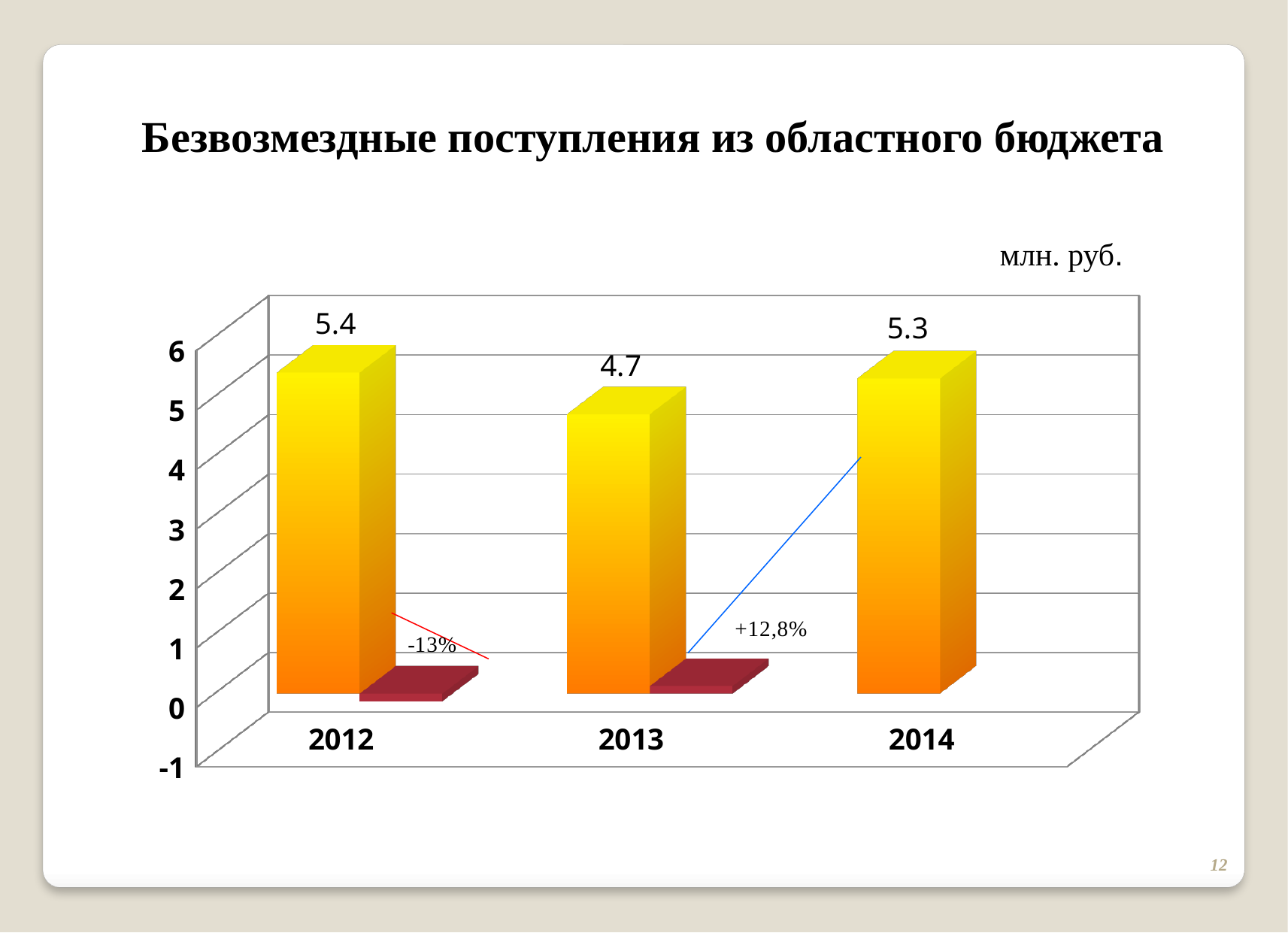
What is the difference between the values for 2014 and 2013? 0.6 What is the difference between the values for 2012 and 2013? 0.7 What is the value for 2014? 5.3 What unit is indicated for the values on the chart? млн. руб. How many years are shown on the x axis? 3 Which is larger, the value for 2012 or the value for 2013? 2012 What kind of chart is shown on the slide? bar chart Is the value for 2013 greater or less than 5? less Which year has the highest value? 2012 What is the value for 2013? 4.7 What is the value for 2012? 5.4 Which year has the lowest value? 2013